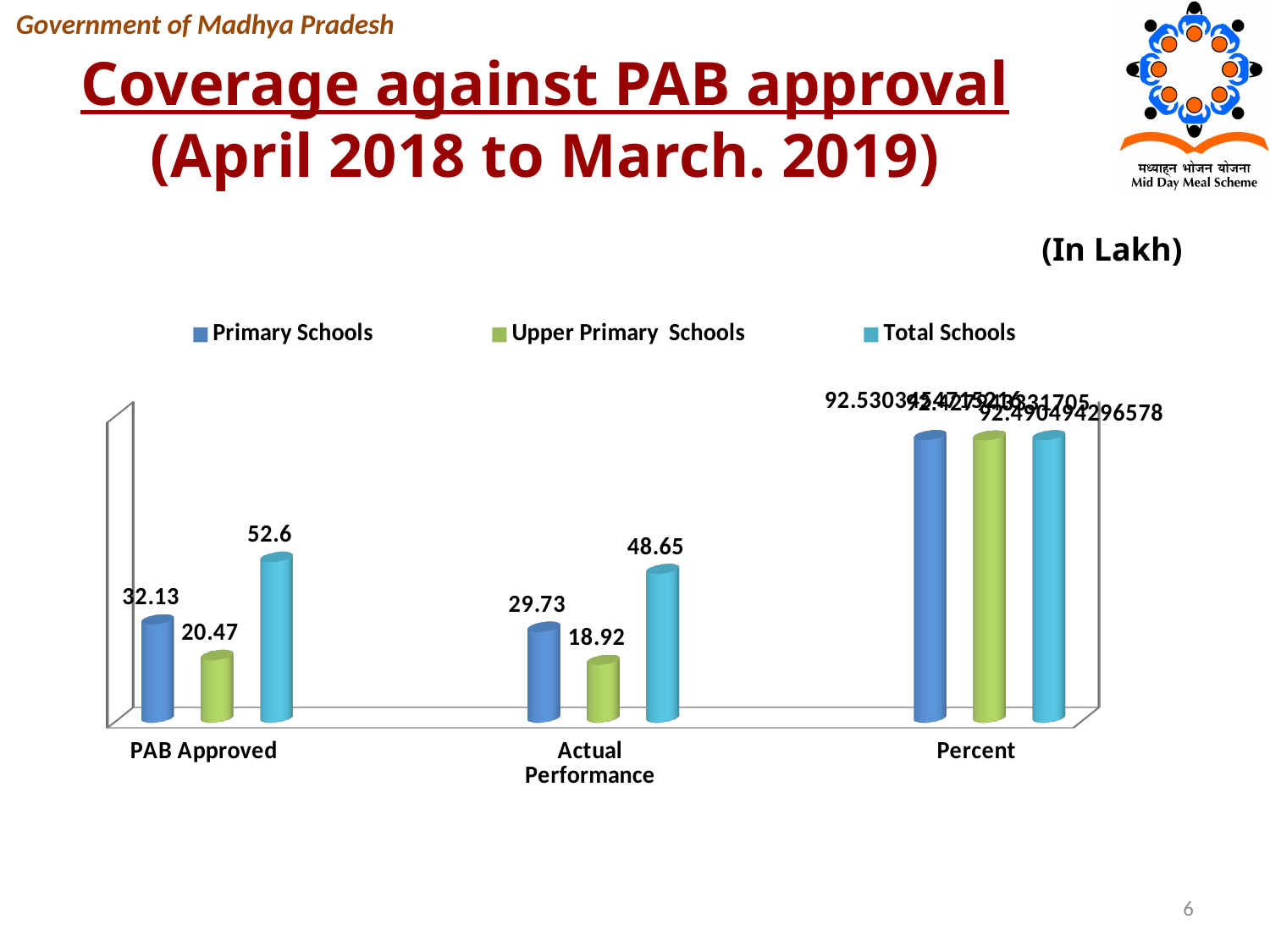
What kind of chart is shown on the slide? Bar chart What is the value for Total Schools in the PAB Approved category? 52.6 How many series does the legend list? 3 What is the value for Upper Primary Schools in the PAB Approved category? 20.47 What is the value for Upper Primary Schools in the Actual Performance category? 18.92 What is the difference between the Total Schools values for PAB Approved and Actual Performance? 3.95 What is the difference between the Primary Schools values for PAB Approved and Actual Performance? 2.4 Which is larger: the Primary Schools value for PAB Approved or for Actual Performance? PAB Approved Which series has the lowest value in the Actual Performance category? Upper Primary Schools What is the value for Primary Schools in the Actual Performance category? 29.73 What is the value for Total Schools in the Actual Performance category? 48.65 What is the value for Primary Schools in the PAB Approved category? 32.13